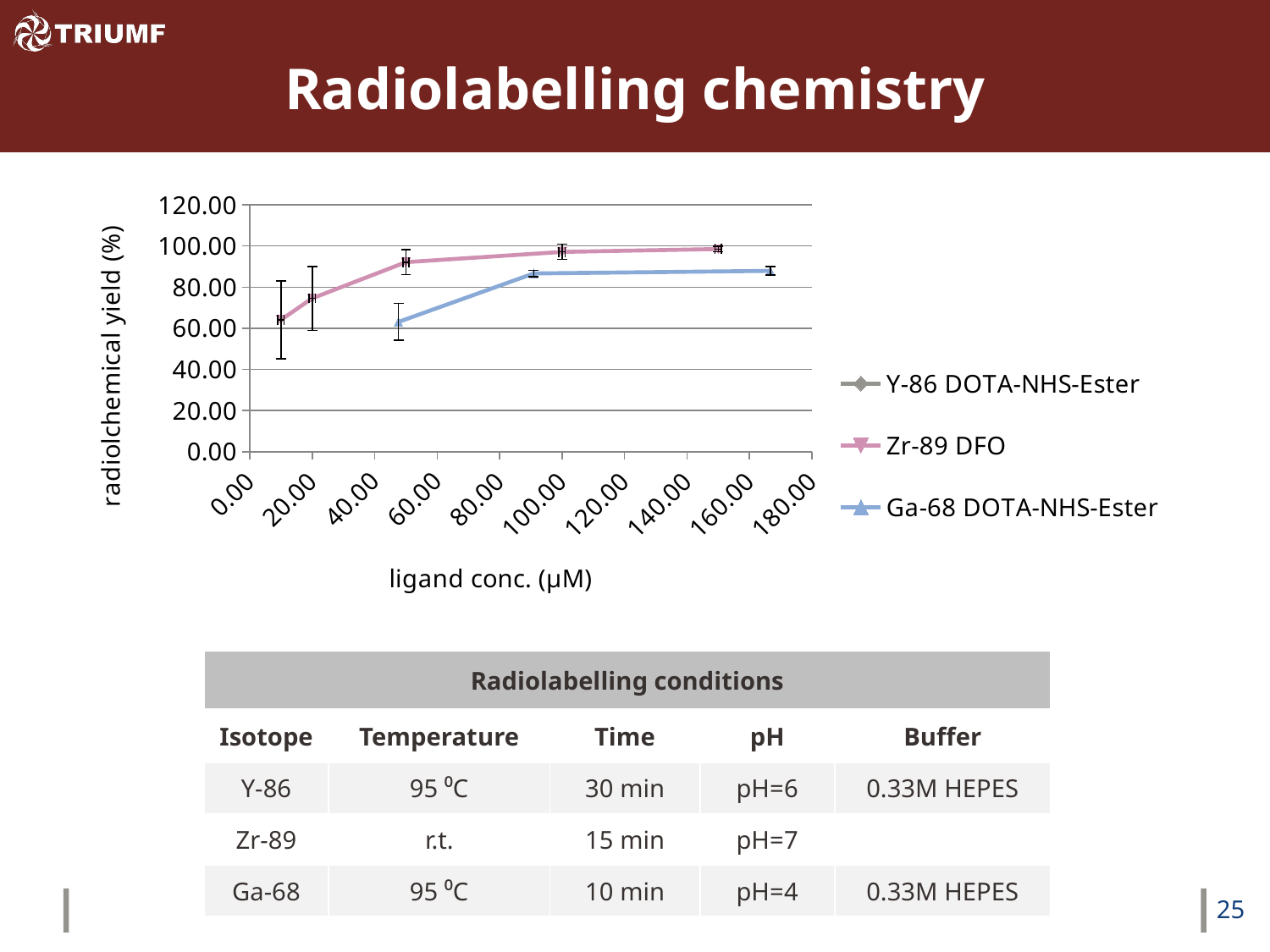
How many data points are plotted for the Zr-89 DFO series? 5 Is the radiochemical yield for Ga-68 DOTA-NHS-Ester at its lowest ligand concentration greater or less than 80? less Is the highest radiochemical yield for Ga-68 DOTA-NHS-Ester greater or less than 100? less How many series does the chart legend list? 3 Which series reaches the higher radiochemical yield at high ligand concentration, Zr-89 DFO or Ga-68 DOTA-NHS-Ester? Zr-89 DFO What is the label of the chart's y axis? radiolchemical yield (%) What is the label of the chart's x axis? ligand conc. (µM) Does the radiochemical yield for Ga-68 DOTA-NHS-Ester rise or fall as ligand concentration increases? rise What kind of chart is shown on the slide? line chart Does the radiochemical yield for Zr-89 DFO rise or fall as ligand concentration increases? rise Is the highest radiochemical yield for Zr-89 DFO greater or less than 80? greater How many data points are plotted for the Ga-68 DOTA-NHS-Ester series? 3